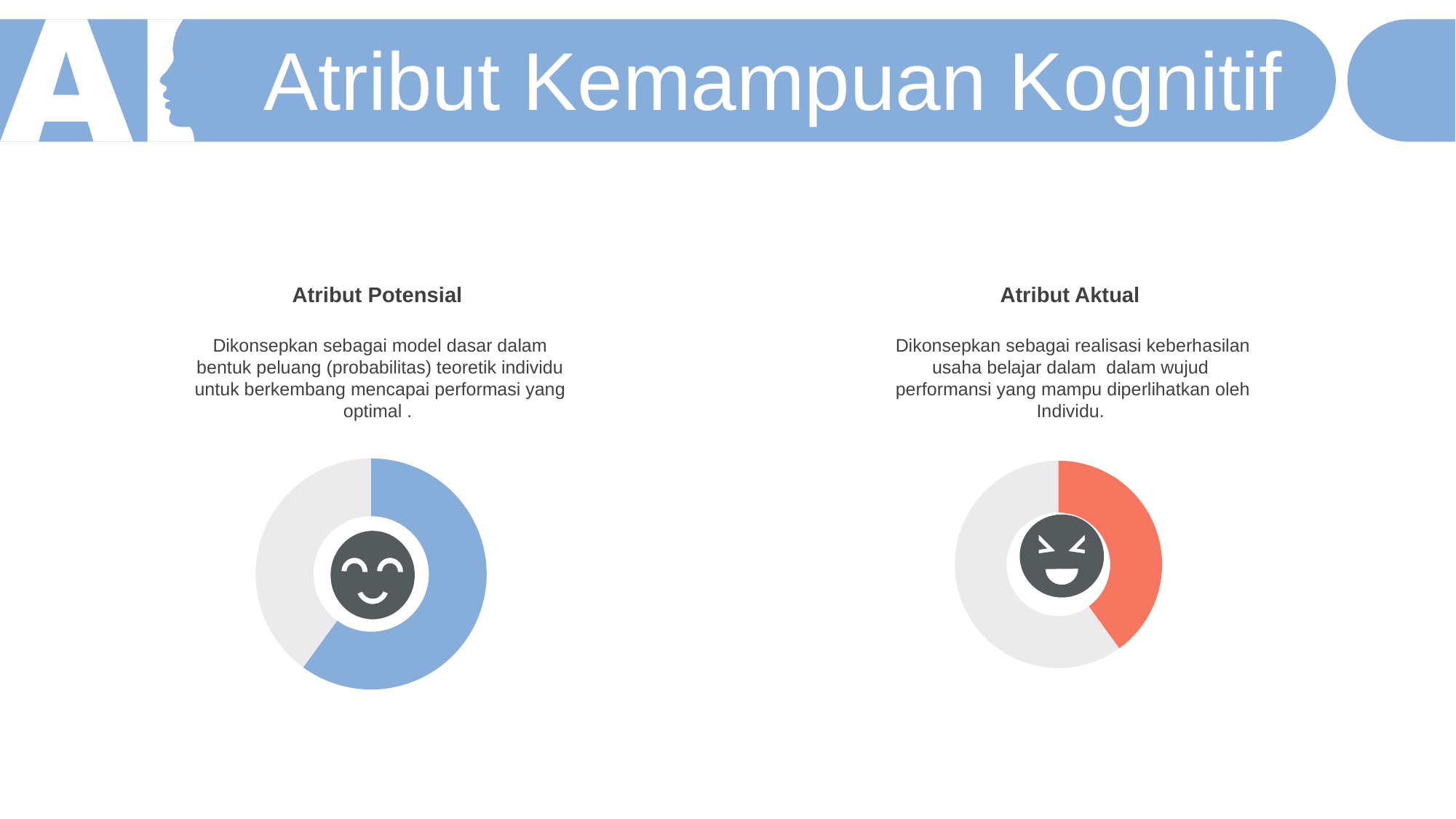
In the "Atribut Aktual" chart, how many segments does the donut have? 2 What kind of chart is shown under the heading "Atribut Potensial"? Donut chart What kind of chart is shown under the heading "Atribut Aktual"? Donut chart How many charts are shown on the slide? 2 What colour is the highlighted segment in the "Atribut Aktual" chart? Orange In the "Atribut Aktual" chart, is the coloured portion larger or smaller than the grey portion? Smaller In the "Atribut Potensial" chart, is the coloured portion larger or smaller than the grey portion? Larger In the "Atribut Potensial" chart, how many segments does the donut have? 2 What colour is the highlighted segment in the "Atribut Potensial" chart? Blue Which chart has the larger coloured (non-grey) portion, "Atribut Potensial" or "Atribut Aktual"? Atribut Potensial